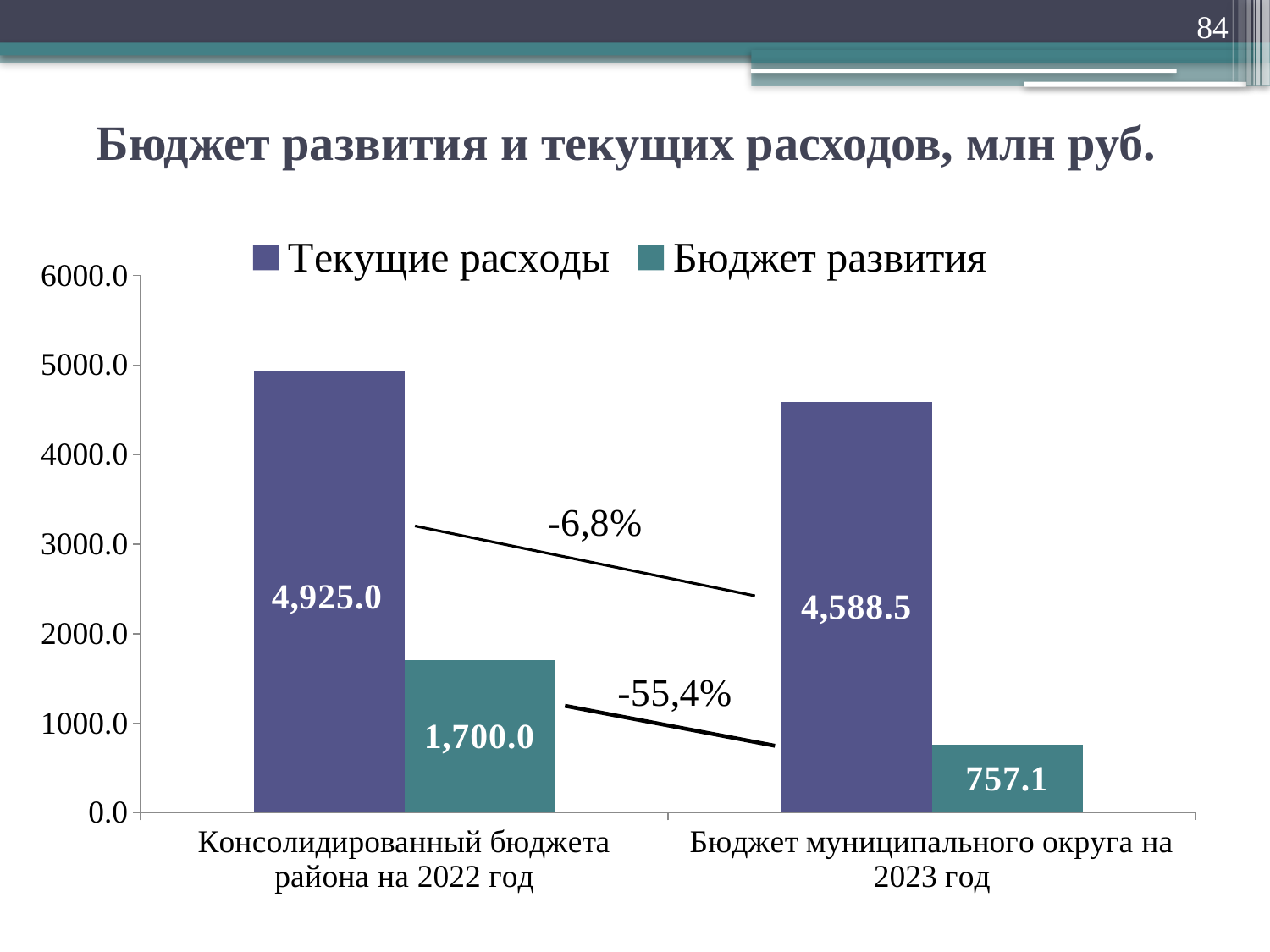
Which is larger: Бюджет развития for 2022 or Бюджет развития for 2023? Бюджет развития for 2022 What is the value of Текущие расходы for Бюджет муниципального округа на 2023 год? 4,588.5 What is the value of Текущие расходы for Консолидированный бюджета района на 2022 год? 4,925.0 What kind of chart is shown on the slide? Bar chart What percentage change is annotated between the Бюджет развития bars? -55,4% Which bar has the lowest value on the chart? Бюджет развития for Бюджет муниципального округа на 2023 год What is the value of Бюджет развития for Бюджет муниципального округа на 2023 год? 757.1 What is the value of Бюджет развития for Консолидированный бюджета района на 2022 год? 1,700.0 What is the difference between Текущие расходы in 2022 (4,925.0) and in 2023 (4,588.5)? 336.5 Which bar has the highest value on the chart? Текущие расходы for Консолидированный бюджета района на 2022 год How many series does the legend list? 2 What is the difference between Бюджет развития in 2022 (1,700.0) and in 2023 (757.1)? 942.9